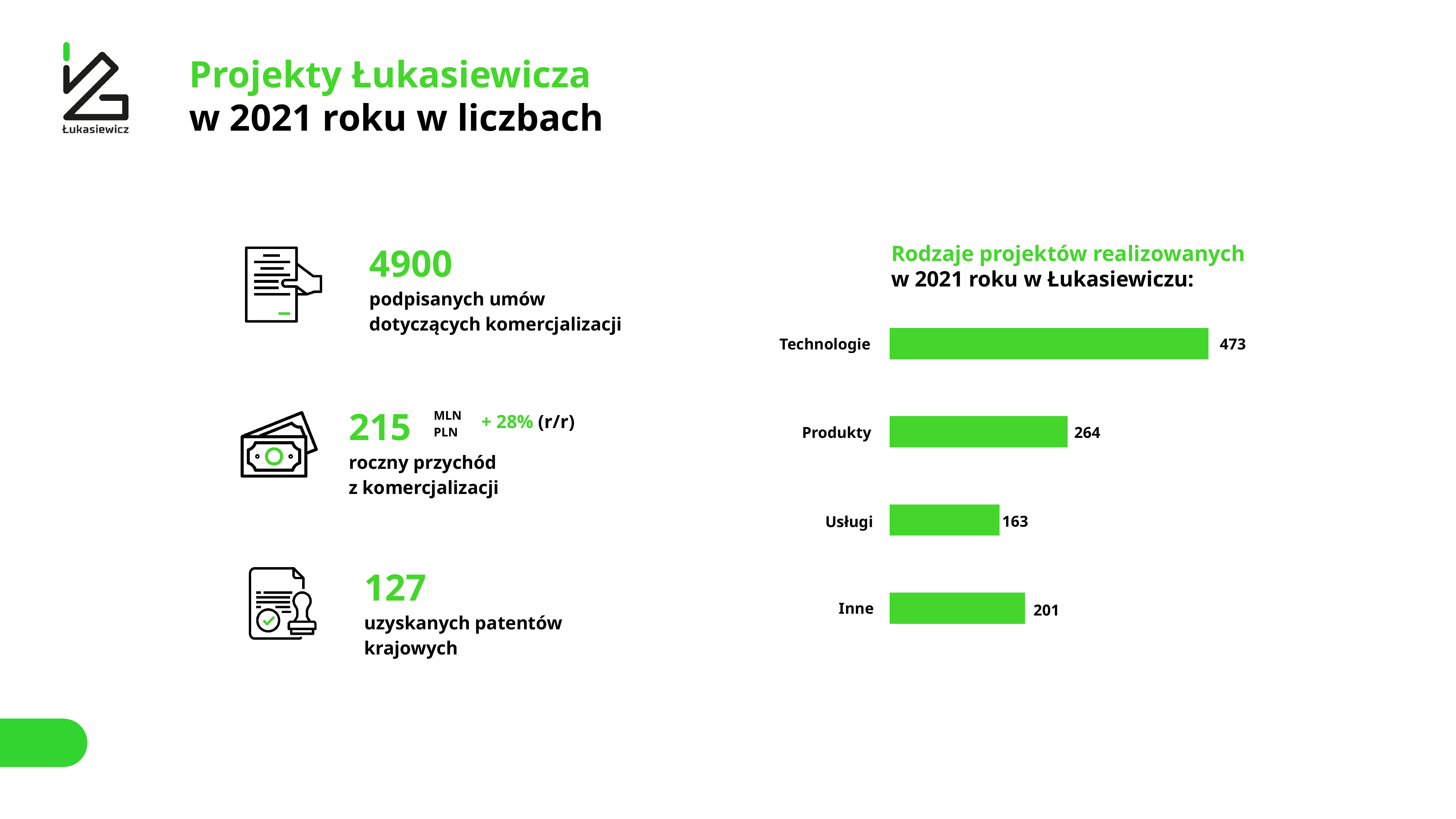
Which category has the lowest value in the chart? Usługi What is the value for Usługi in the chart? 163 What is the value for Produkty in the chart? 264 What is the difference between the values for Technologie and Produkty? 209 What is the title of the chart? Rodzaje projektów realizowanych w 2021 roku w Łukasiewiczu: How many categories are shown in the chart? 4 What is the value for Inne in the chart? 201 Which category has the highest value in the chart? Technologie What kind of chart is shown on the slide? Bar chart What is the difference between the values for Inne and Usługi? 38 What is the value for Technologie in the chart? 473 Which is larger, the value for Produkty or the value for Inne? Produkty